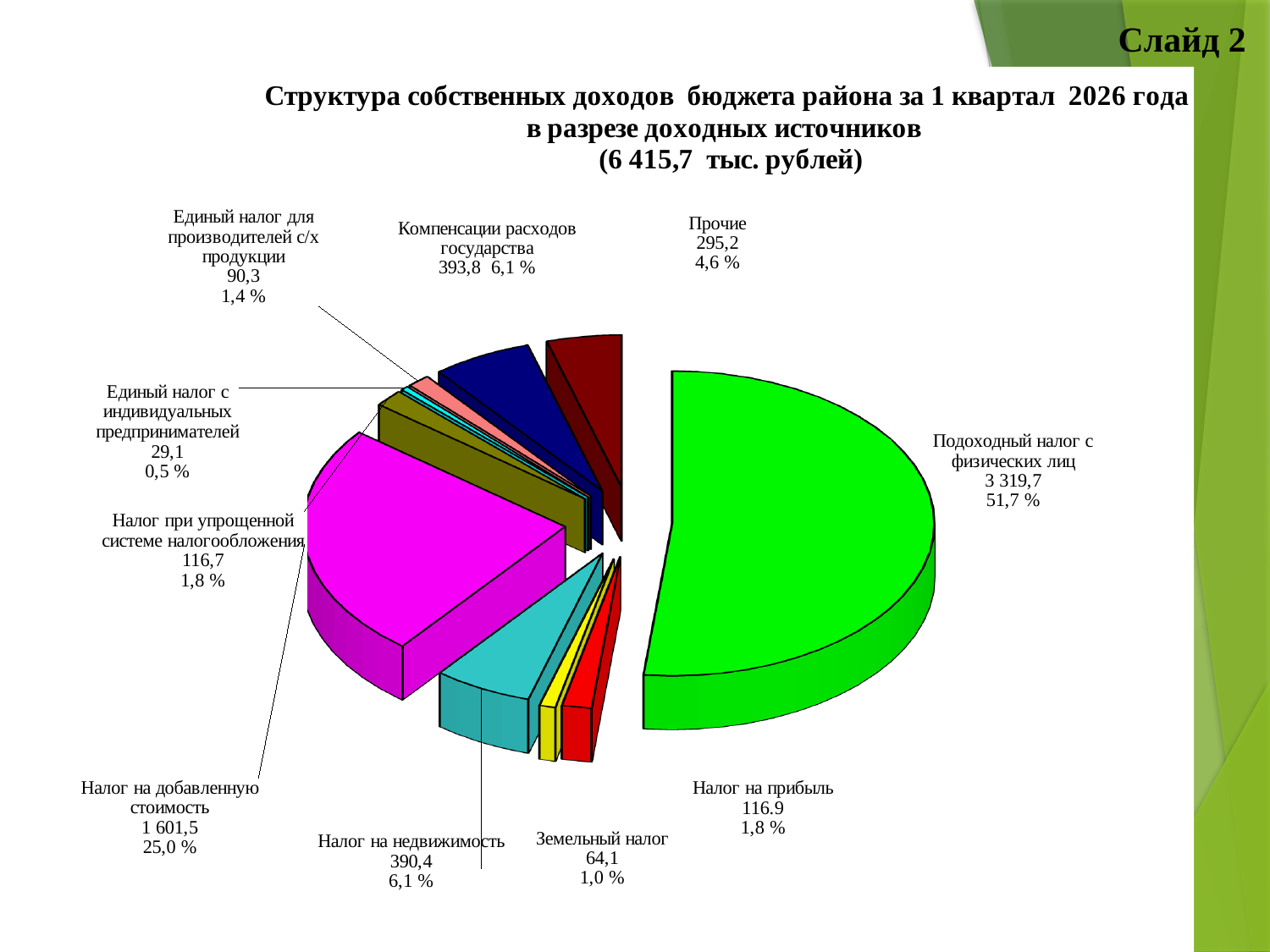
What is the difference between the values for Прочие and Налог на прибыль? 178,3 What percentage share does Компенсации расходов государства have? 6,1 % What share of the pie does Подоходный налог с физических лиц represent? 51,7 % What is the value for Налог на добавленную стоимость? 1 601,5 What type of chart is shown on the slide? Pie chart Which is larger: Прочие or Земельный налог? Прочие What is the value for Подоходный налог с физических лиц? 3 319,7 Which category has the largest slice of the pie? Подоходный налог с физических лиц Which category has the smallest slice of the pie? Единый налог с индивидуальных предпринимателей What is the difference between the values for Подоходный налог с физических лиц and Налог на добавленную стоимость? 1 718,2 What total amount (in тыс. рублей) is stated in the chart title? 6 415,7 How many categories are shown in the pie chart? 10